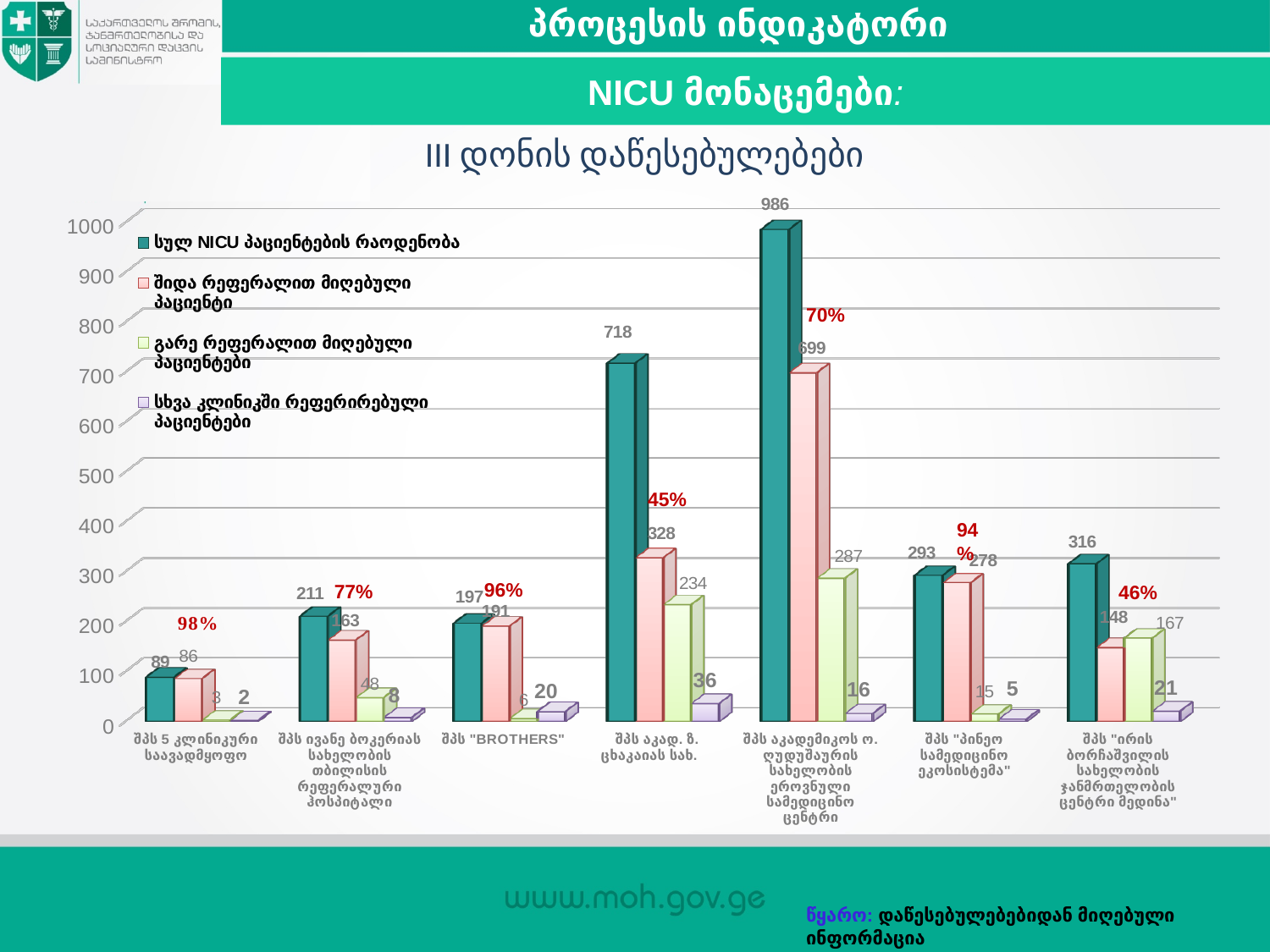
What is the value of შიდა რეფერალით მიღებული პაციენტი for შპს აკად. ზ. ცხაკაიას სახ.? 328 What is the difference between სულ NICU პაციენტების რაოდენობა and შიდა რეფერალით მიღებული პაციენტი for შპს აკადემიკოს ო. ღუდუშაურის სახელობის ეროვნული სამედიცინო ცენტრი? 287 What is the value of გარე რეფერალით მიღებული პაციენტები for შპს "ირის ბორჩაშვილის სახელობის ჯანმრთელობის ცენტრი მედინა"? 167 Which institution has the lowest value of სულ NICU პაციენტების რაოდენობა? შპს 5 კლინიკური საავადმყოფო What type of chart is shown on the slide? bar chart What is the value of სულ NICU პაციენტების რაოდენობა for შპს "BROTHERS"? 197 Which is larger for შპს "ირის ბორჩაშვილის სახელობის ჯანმრთელობის ცენტრი მედინა": შიდა რეფერალით მიღებული პაციენტი or გარე რეფერალით მიღებული პაციენტები? გარე რეფერალით მიღებული პაციენტები How many categories (institutions) are shown on the x axis? 7 What is the title of the chart? III დონის დაწესებულებები How many series does the legend list? 4 Which institution has the highest value of სულ NICU პაციენტების რაოდენობა? შპს აკადემიკოს ო. ღუდუშაურის სახელობის ეროვნული სამედიცინო ცენტრი What percentage label is shown above the bars for შპს ივანე ბოკერიას სახელობის თბილისის რეფერალური ჰოსპიტალი? 77%